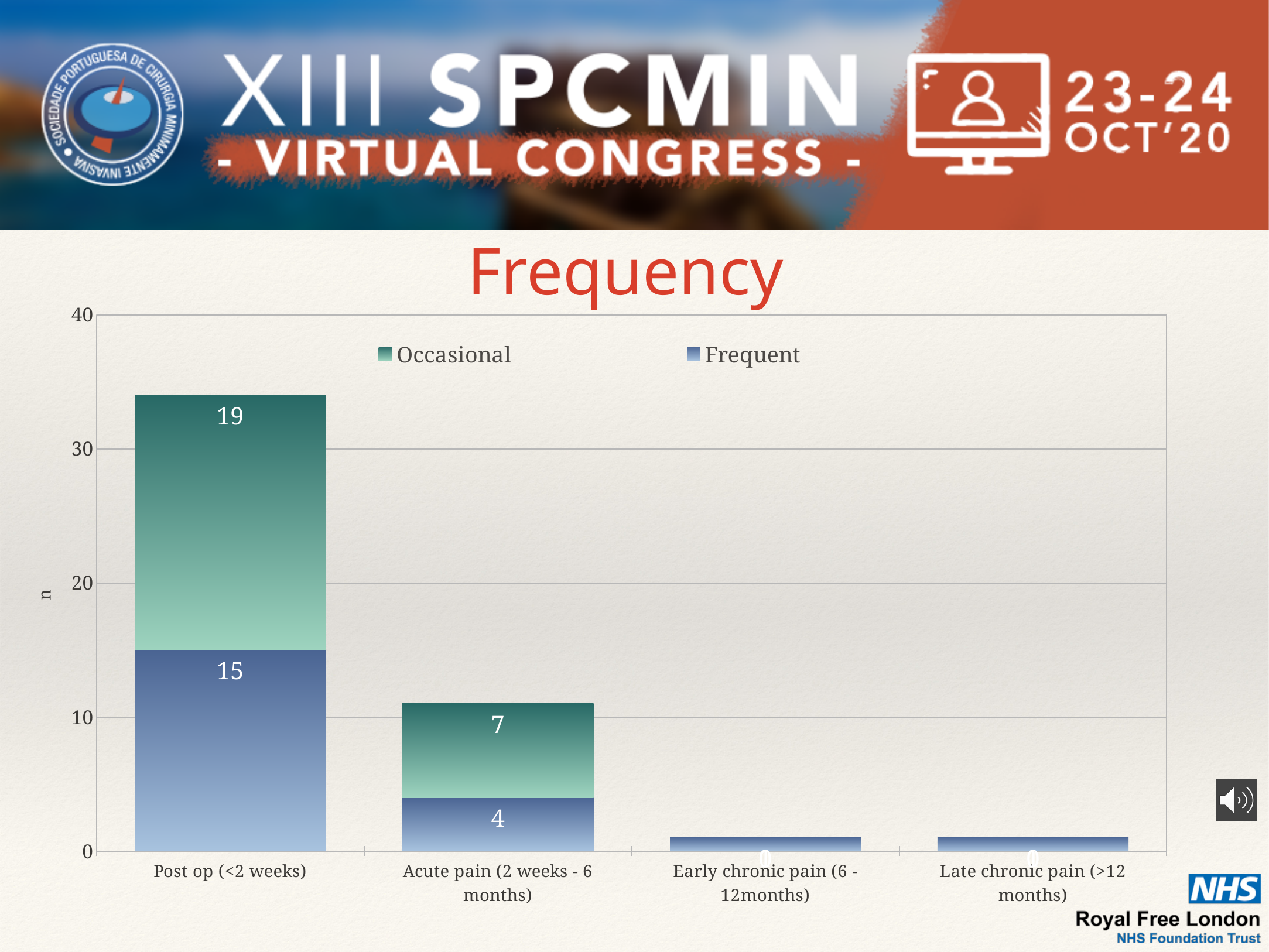
How many series does the legend list? 2 What is the Occasional value for Acute pain (2 weeks - 6 months)? 7 How many categories are shown on the x axis? 4 What is the Frequent value for Post op (<2 weeks)? 15 What is the difference between the Occasional and Frequent values for Post op (<2 weeks)? 4 What kind of chart is shown on the slide? Stacked bar chart Which category has the highest total bar? Post op (<2 weeks) What is the total of the stacked bar for Post op (<2 weeks)? 34 What is the total of the stacked bar for Acute pain (2 weeks - 6 months)? 11 What is the Occasional value for Post op (<2 weeks)? 19 Which is larger for Acute pain (2 weeks - 6 months): the Occasional value or the Frequent value? Occasional What is the Frequent value for Acute pain (2 weeks - 6 months)? 4